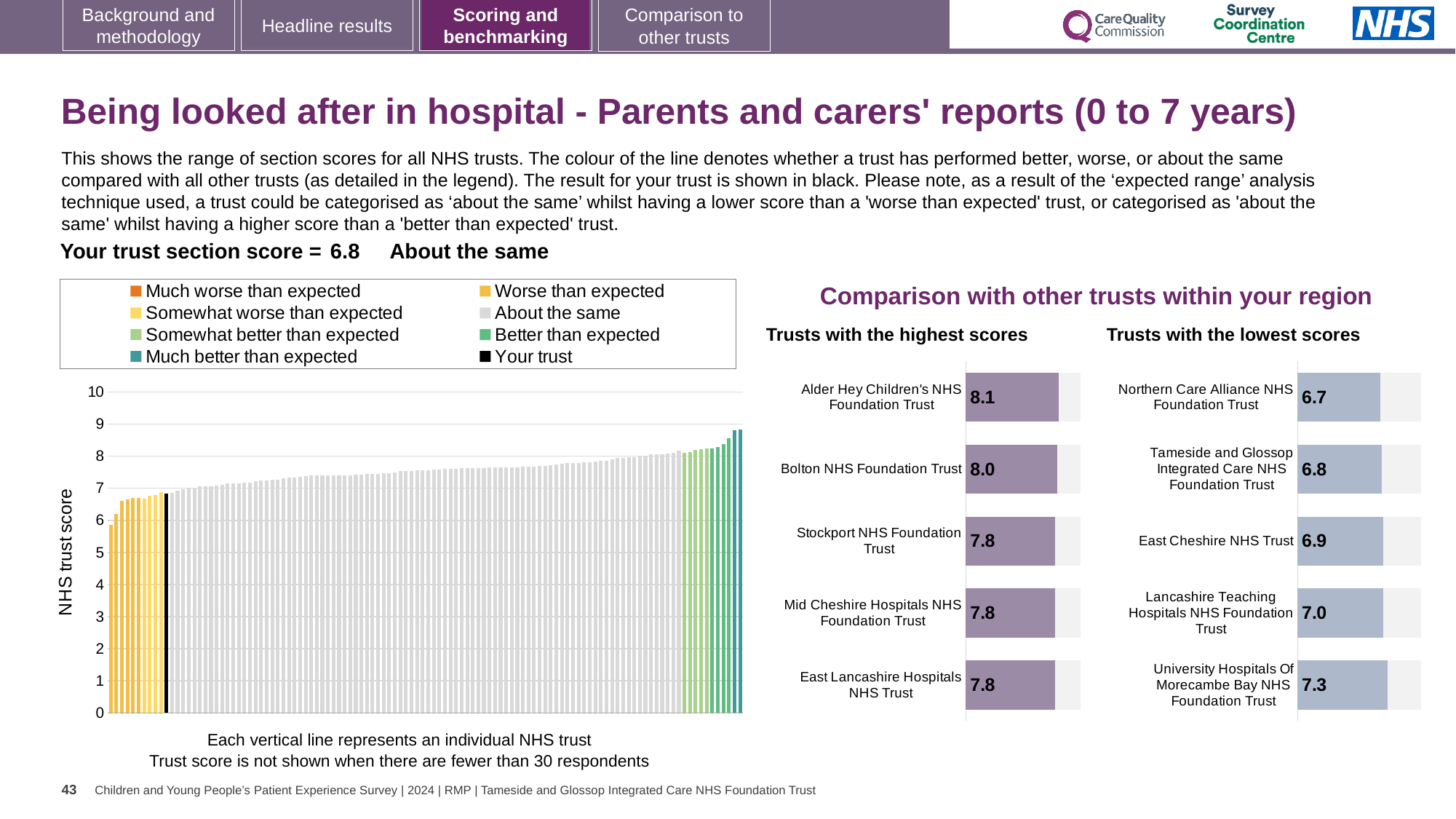
How many trusts are shown in the 'Trusts with the highest scores' chart? 5 In the 'Trusts with the lowest scores' chart, which has the higher score: Lancashire Teaching Hospitals NHS Foundation Trust or Tameside and Glossop Integrated Care NHS Foundation Trust? Lancashire Teaching Hospitals NHS Foundation Trust In the 'Trusts with the lowest scores' chart, which trust has the lowest score? Northern Care Alliance NHS Foundation Trust In the 'Trusts with the highest scores' chart, what is the difference between the scores of Alder Hey Children's NHS Foundation Trust and Stockport NHS Foundation Trust? 0.3 In the 'Trusts with the lowest scores' chart, which trust has the highest score? University Hospitals Of Morecambe Bay NHS Foundation Trust In the large chart on the left, do the bar values rise or fall from left to right? rise In the large chart on the left, is the value of the tallest bar greater or less than 8? greater In the 'Trusts with the highest scores' chart, what is the score for Alder Hey Children's NHS Foundation Trust? 8.1 In the 'Trusts with the highest scores' chart, what is the score for Bolton NHS Foundation Trust? 8.0 In the 'Trusts with the lowest scores' chart, what is the score for East Cheshire NHS Trust? 6.9 In the 'Trusts with the lowest scores' chart, what is the difference between the scores of University Hospitals Of Morecambe Bay NHS Foundation Trust and Northern Care Alliance NHS Foundation Trust? 0.6 How many entries does the legend of the large chart on the left list? 8